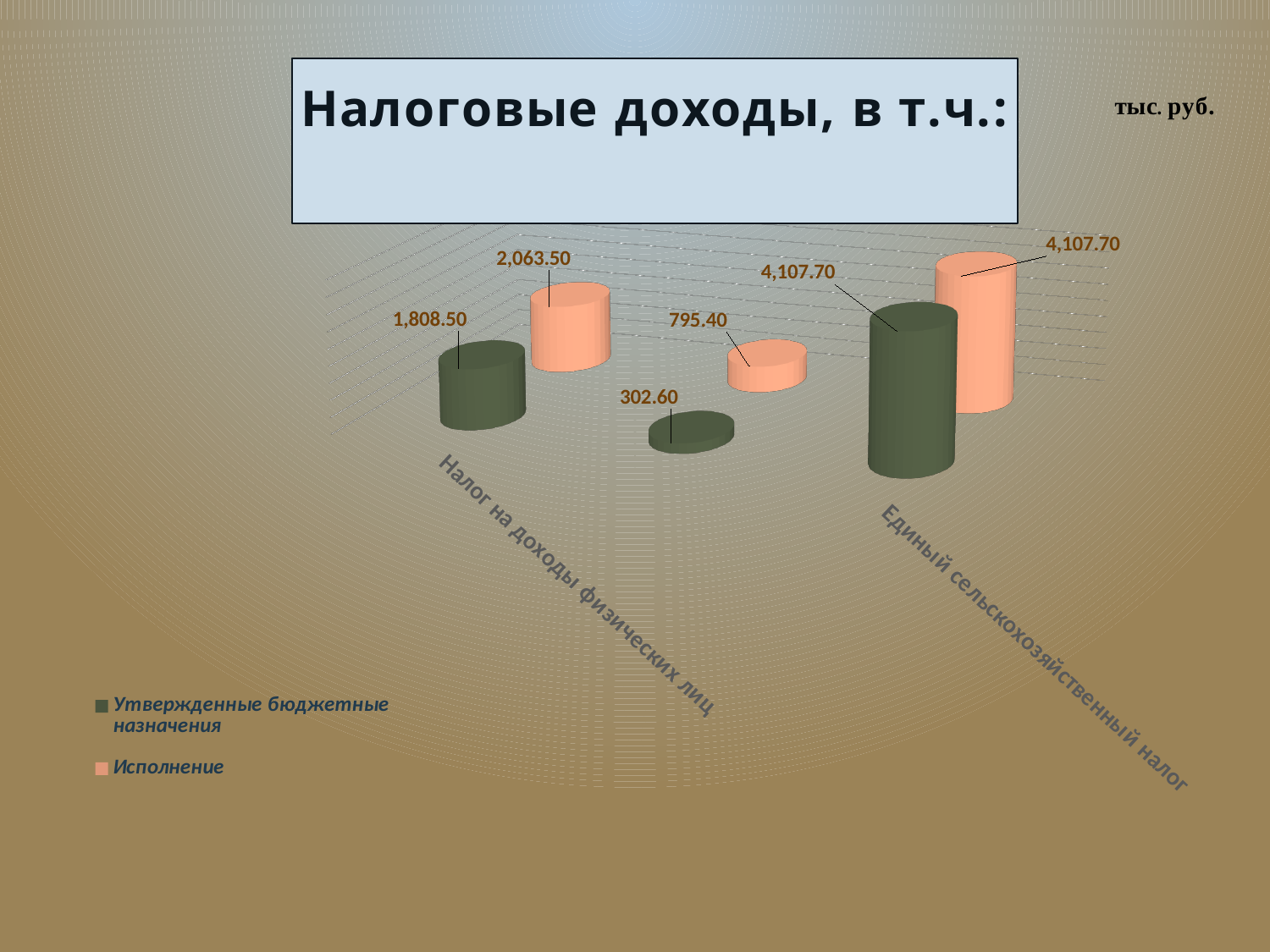
What is the value of Утвержденные бюджетные назначения for Единый сельскохозяйственный налог? 4,107.70 What is the difference between Исполнение and Утвержденные бюджетные назначения for Налог на доходы физических лиц? 255.00 For Налог на доходы физических лиц, which is larger: Утвержденные бюджетные назначения or Исполнение? Исполнение What is the title of the chart? Налоговые доходы, в т.ч.: What unit is indicated for the chart values? тыс. руб. What is the value of Исполнение for Налог на доходы физических лиц? 2,063.50 Which category has the highest Исполнение value? Единый сельскохозяйственный налог How many categories are shown on the chart? 3 What is the value of Утвержденные бюджетные назначения for Налог на доходы физических лиц? 1,808.50 What is the value of Исполнение for Единый сельскохозяйственный налог? 4,107.70 How many series does the legend list? 2 What kind of chart is shown on the slide? Bar chart